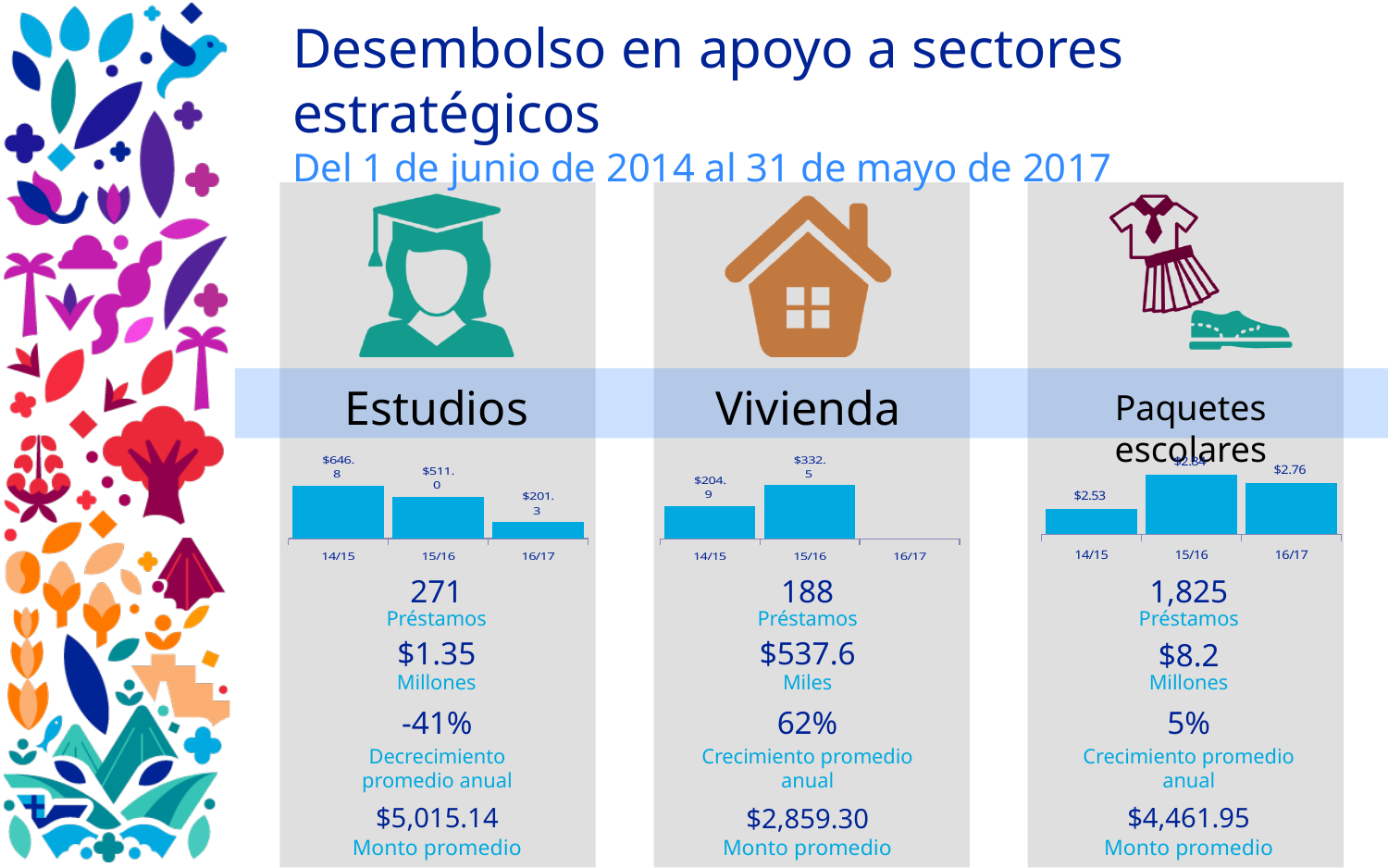
In the Vivienda chart, which is larger, the value for 14/15 or the value for 15/16? 15/16 In the Paquetes escolares chart, which period has the lowest value? 14/15 In the Vivienda chart, what is the value for 14/15? $204.9 In the Estudios chart, what is the value for 14/15? $646.8 In the Estudios chart, what is the difference between the 14/15 and 15/16 values? $135.8 In the Paquetes escolares chart, what is the value for 16/17? $2.76 In the Vivienda chart, what is the value for 15/16? $332.5 In the Estudios chart, do the values rise or fall from 14/15 to 16/17? fall In the Estudios chart, what is the value for 16/17? $201.3 What type of chart is used under Estudios? bar chart In the Paquetes escolares chart, what is the value for 14/15? $2.53 In the Estudios chart, which period has the highest value? 14/15